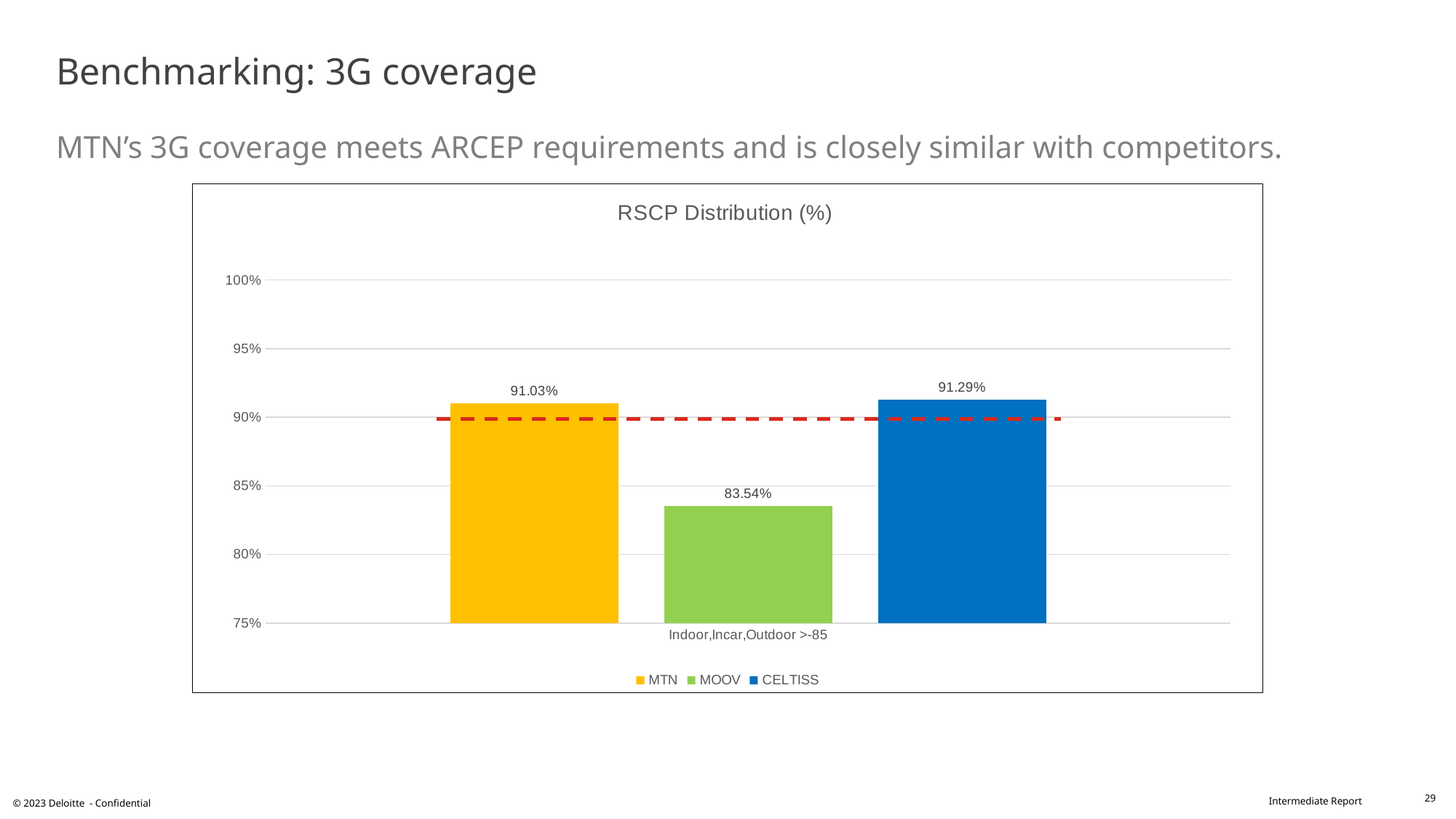
What is the value for MOOV in the RSCP Distribution (%) chart? 83.54% What kind of chart is the RSCP Distribution (%) chart? Bar chart Which series has the lowest value in the RSCP Distribution (%) chart? MOOV What is the value for CELTISS in the RSCP Distribution (%) chart? 91.29% Is the value for MOOV in the RSCP Distribution (%) chart greater or less than 85%? less What is the value for MTN in the RSCP Distribution (%) chart? 91.03% What colour is the MTN bar in the RSCP Distribution (%) chart? Yellow What is the difference between the MTN and MOOV values in the RSCP Distribution (%) chart? 7.49% Which is larger in the RSCP Distribution (%) chart, the value for MTN or the value for MOOV? MTN How many series does the legend of the RSCP Distribution (%) chart list? 3 Which series has the highest value in the RSCP Distribution (%) chart? CELTISS What is the difference between the CELTISS and MTN values in the RSCP Distribution (%) chart? 0.26%